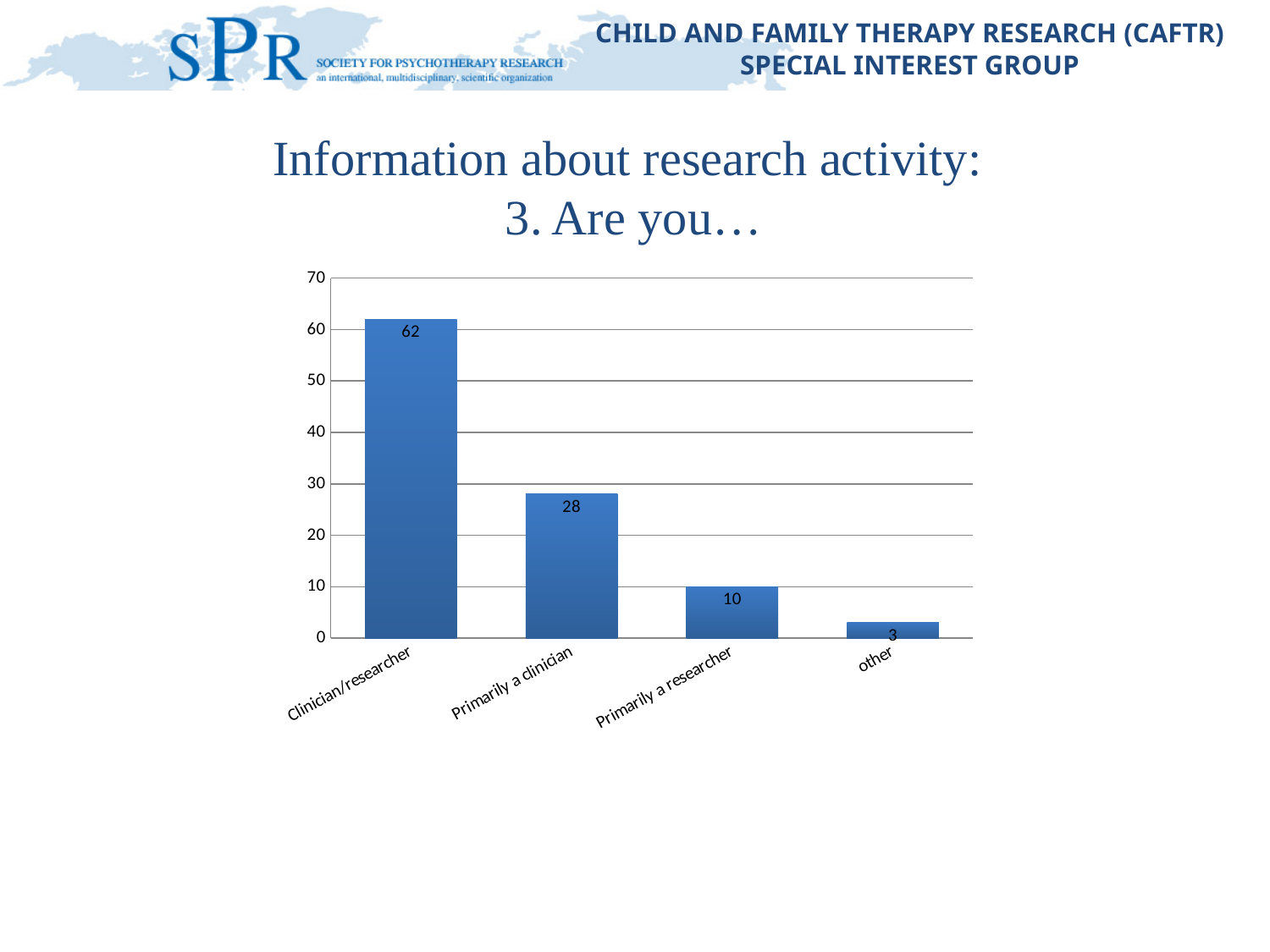
What is the difference between the values for Clinician/researcher and Primarily a clinician? 34 Which category has the highest value? Clinician/researcher Do the values rise or fall from left to right along the x axis? fall How many categories are shown on the x axis? 4 What is the value for Primarily a clinician? 28 What kind of chart is shown on the slide? bar chart Which category has the lowest value? other Is the value for Clinician/researcher greater or less than 50? greater What is the value for Clinician/researcher? 62 What is the value for Primarily a researcher? 10 Which is larger, the value for Primarily a clinician or the value for Primarily a researcher? Primarily a clinician What is the value for other? 3